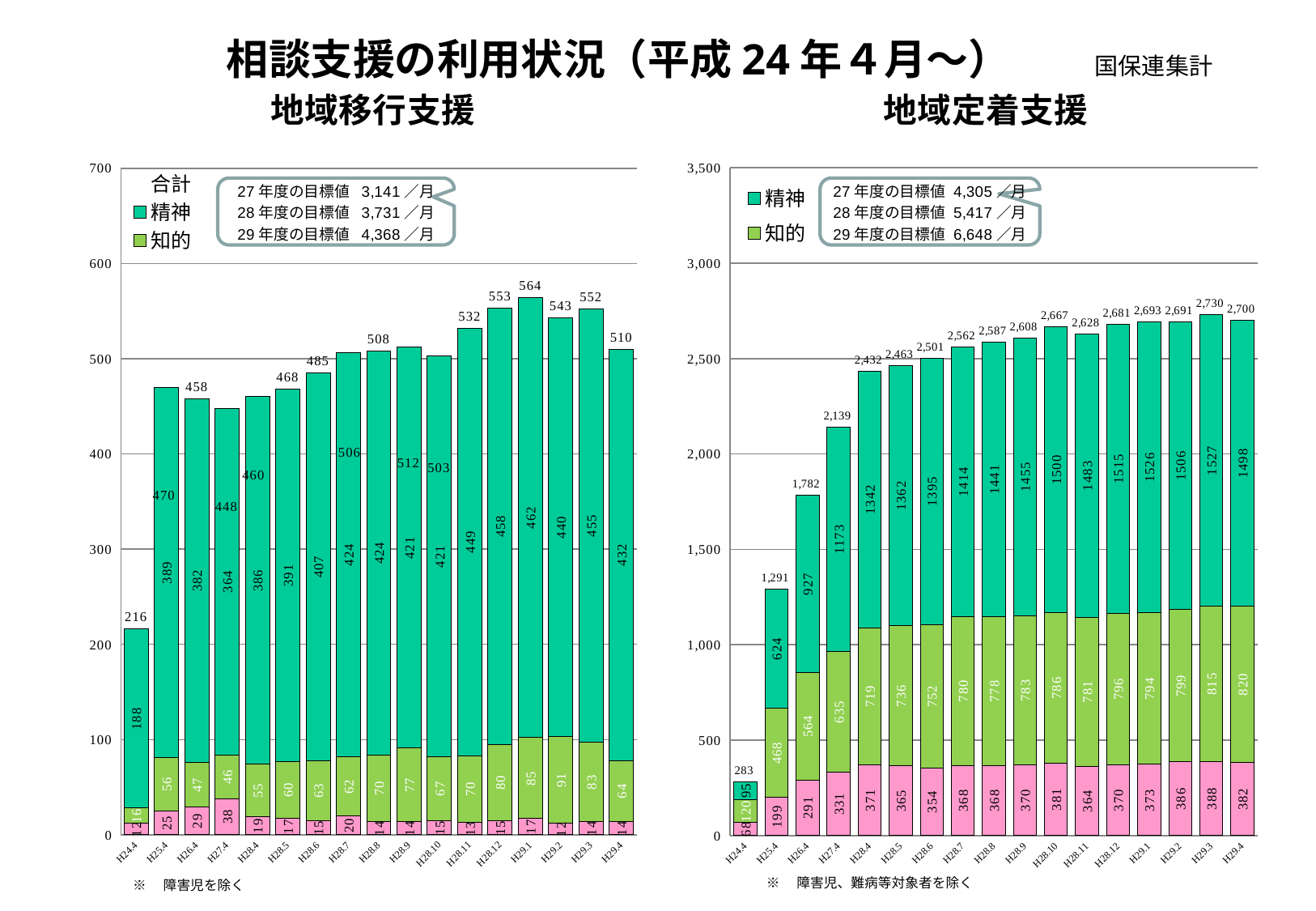
In the 地域移行支援 chart, what is the difference between the 精神 values for H29.1 and H29.4? 30 In the 地域定着支援 chart, what is the 精神 value for H28.10? 1500 In the 地域移行支援 chart, which category has the lowest total? H24.4 What kind of chart is the 地域移行支援 chart? stacked bar chart In the 地域移行支援 chart, which category has the highest total? H29.1 In the 地域移行支援 chart, what is the total value labeled for H29.1? 564 In the 地域定着支援 chart, which category has the lowest total? H24.4 In the 地域定着支援 chart, what is the total value labeled for H29.3? 2,730 How many categories are shown on the x axis of the 地域定着支援 chart? 17 In the 地域定着支援 chart, what is the 29年度の目標値 shown in the callout? 6,648／月 In the 地域定着支援 chart, is the 知的 value for H29.4 larger or smaller than the 知的 value for H28.4? larger In the 地域移行支援 chart, what is the 知的 value for H29.2? 91